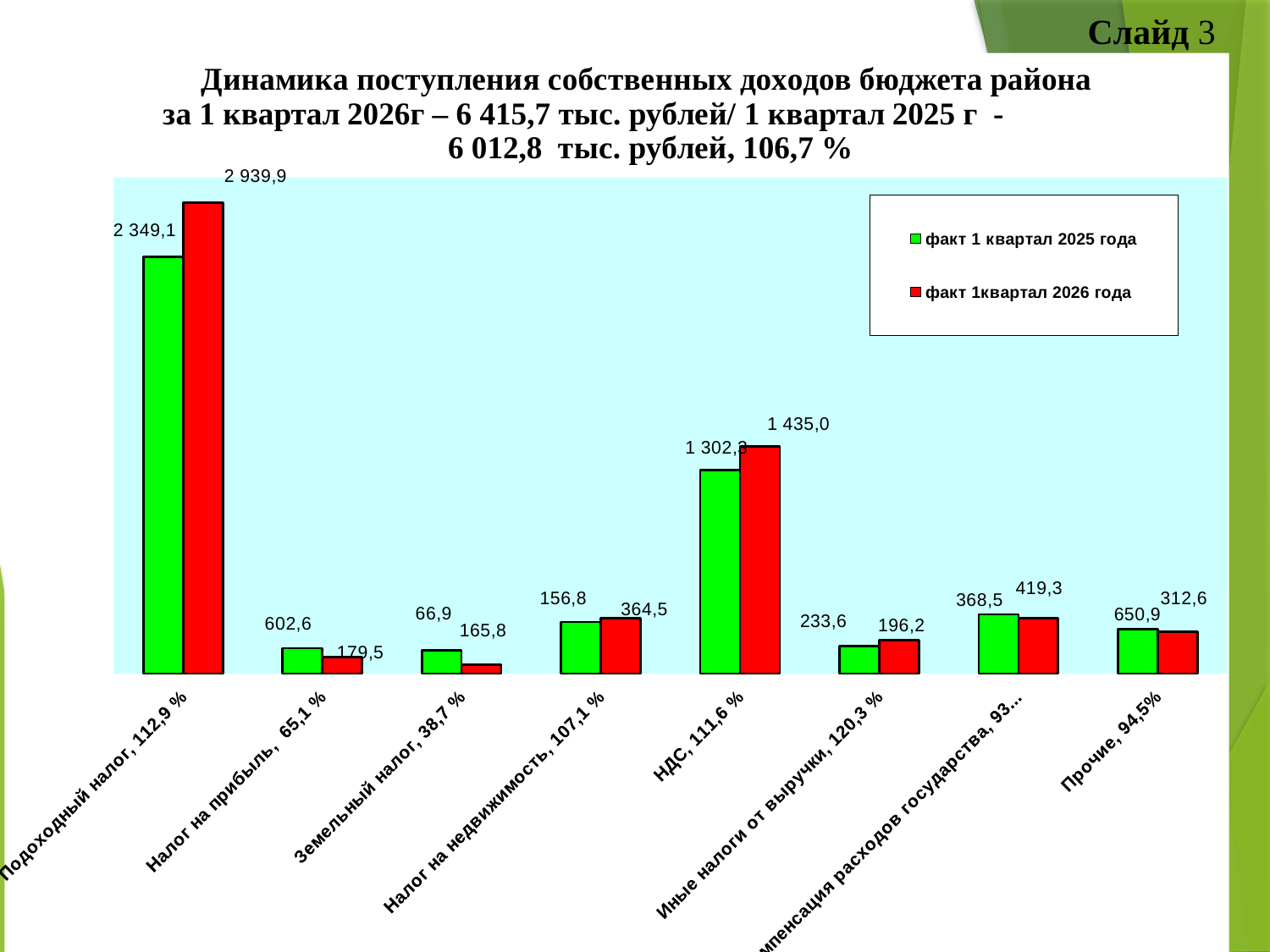
What colour represents the series факт 1квартал 2026 года in the legend? red What is the value for Подоходный налог in the series факт 1квартал 2026 года? 2 939,9 What is the value for Налог на прибыль in the series факт 1квартал 2026 года? 179,5 What is the value for Компенсация расходов государства in the series факт 1 квартал 2025 года? 368,5 What is the difference between the 2026 and 2025 values for Подоходный налог? 590,8 What kind of chart is shown on the slide? bar chart What is the value for Подоходный налог in the series факт 1 квартал 2025 года? 2 349,1 Which category has the highest value in the series факт 1квартал 2026 года? Подоходный налог For Налог на прибыль, which series has the larger value: факт 1 квартал 2025 года or факт 1квартал 2026 года? факт 1 квартал 2025 года What is the value for НДС in the series факт 1квартал 2026 года? 1 435,0 How many series does the legend list? 2 How many categories are plotted along the x axis? 8